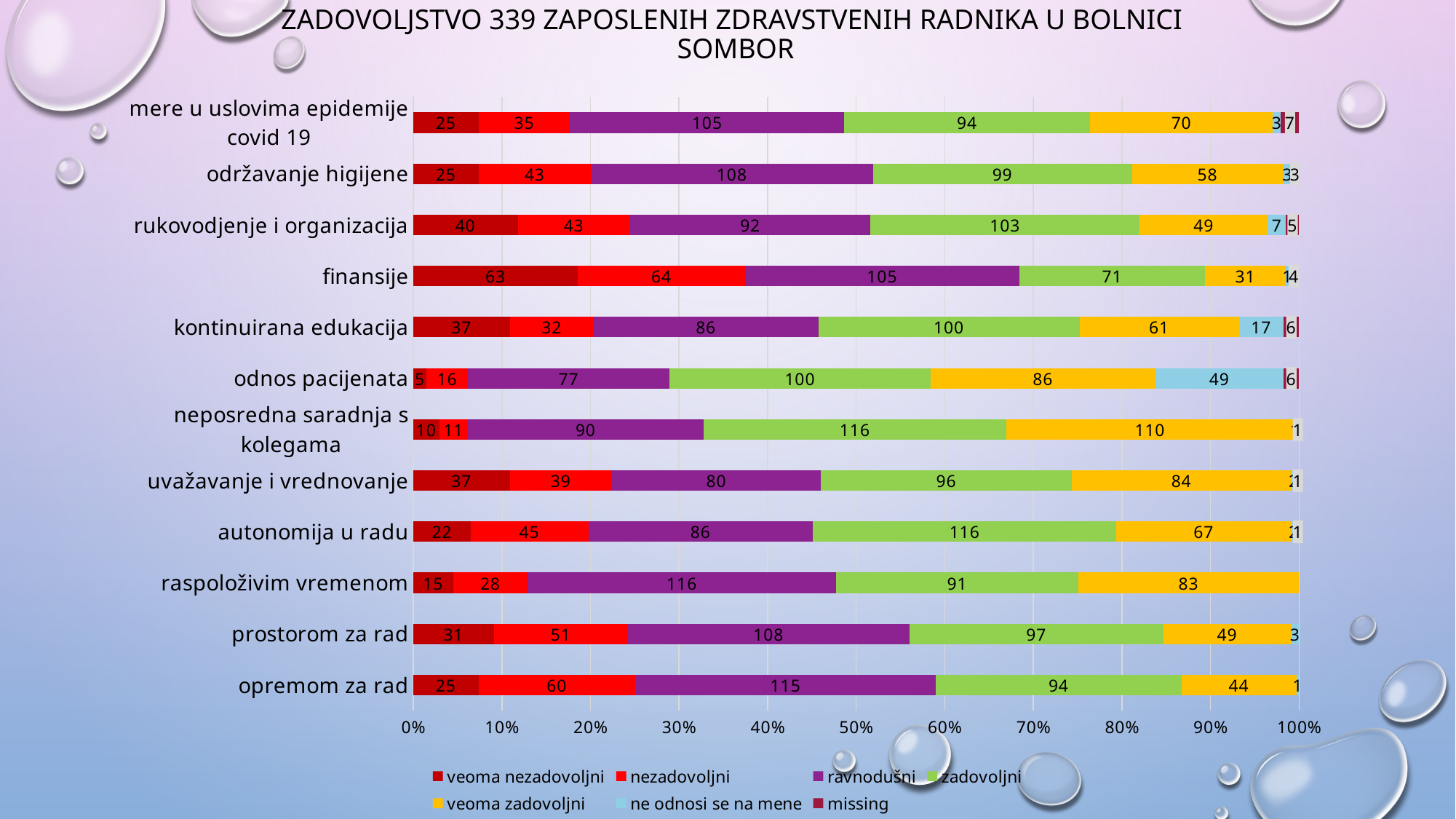
Which category has the highest value for 'veoma zadovoljni'? neposredna saradnja s kolegama Which is larger: 'zadovoljni' for 'održavanje higijene' or 'zadovoljni' for 'rukovodjenje i organizacija'? rukovodjenje i organizacija How many categories are listed on the vertical axis of the chart? 12 What kind of chart is shown on the slide? stacked bar chart What is the value of 'veoma zadovoljni' for 'neposredna saradnja s kolegama'? 110 What is the value of 'zadovoljni' for 'autonomija u radu'? 116 What is the value of 'nezadovoljni' for 'opremom za rad'? 60 What is the value of 'ravnodušni' for 'finansije'? 105 What is the difference between 'zadovoljni' and 'veoma zadovoljni' for 'autonomija u radu'? 49 Which category has the highest value for 'veoma nezadovoljni'? finansije How many series does the legend list? 7 What is the value of 'ne odnosi se na mene' for 'odnos pacijenata'? 49